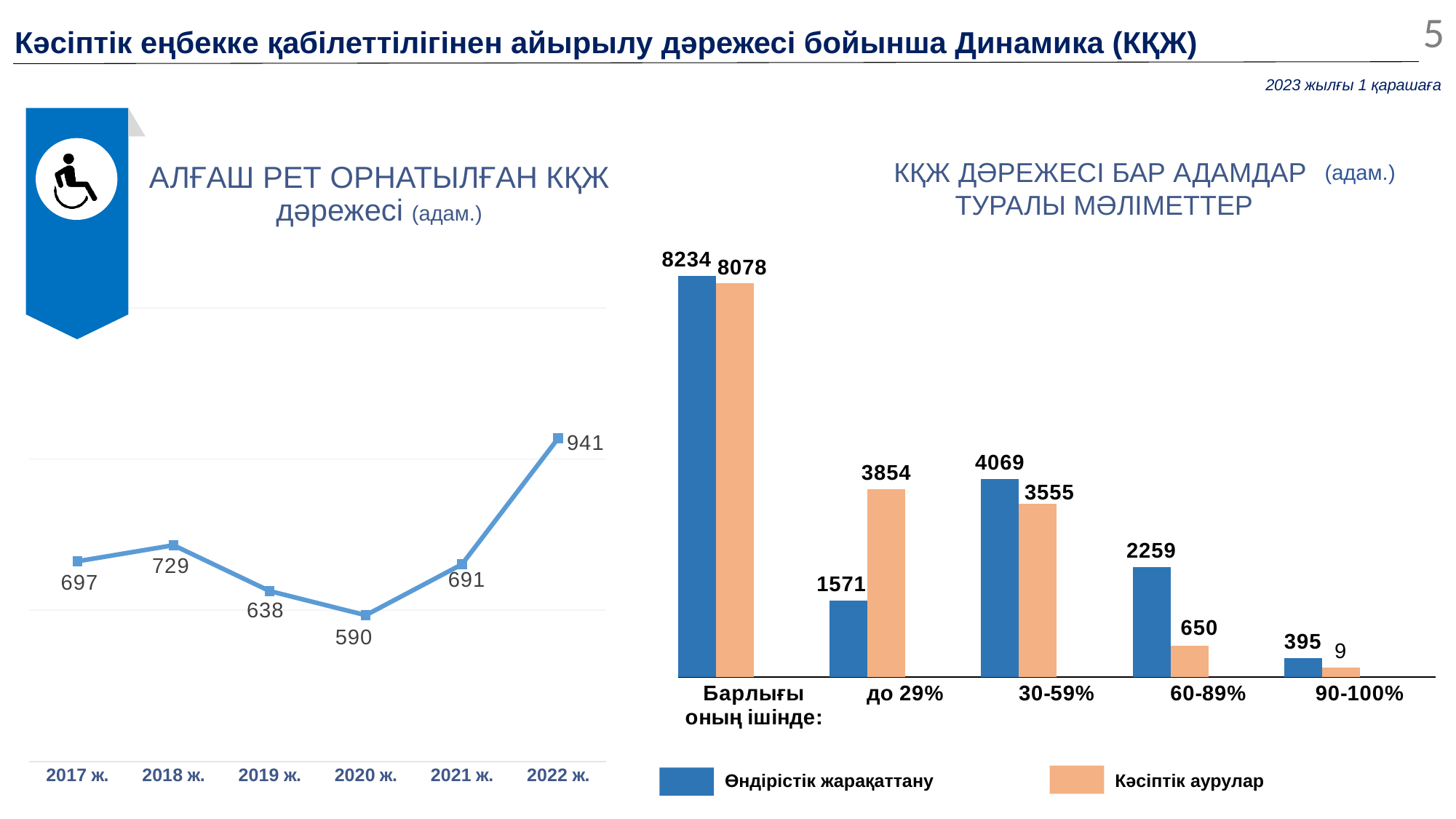
In the left chart (АЛҒАШ РЕТ ОРНАТЫЛҒАН КҚЖ дәрежесі), which year has the lowest value? 2020 ж. In the left chart (АЛҒАШ РЕТ ОРНАТЫЛҒАН КҚЖ дәрежесі), what is the difference between the values for 2022 ж. and 2021 ж.? 250 In the left chart (АЛҒАШ РЕТ ОРНАТЫЛҒАН КҚЖ дәрежесі), what is the value for 2020 ж.? 590 How many series does the legend of the right chart (КҚЖ ДӘРЕЖЕСІ БАР АДАМДАР ТУРАЛЫ МӘЛІМЕТТЕР) list? 2 In the right chart (КҚЖ ДӘРЕЖЕСІ БАР АДАМДАР ТУРАЛЫ МӘЛІМЕТТЕР), what is the value of Өндірістік жарақаттану for 60-89%? 2259 In the right chart (КҚЖ ДӘРЕЖЕСІ БАР АДАМДАР ТУРАЛЫ МӘЛІМЕТТЕР), what is the value of Кәсіптік аурулар for до 29%? 3854 In the left chart (АЛҒАШ РЕТ ОРНАТЫЛҒАН КҚЖ дәрежесі), which year has the highest value? 2022 ж. In the right chart (КҚЖ ДӘРЕЖЕСІ БАР АДАМДАР ТУРАЛЫ МӘЛІМЕТТЕР), which is larger for 30-59%: Өндірістік жарақаттану or Кәсіптік аурулар? Өндірістік жарақаттану What kind of chart is the left chart (АЛҒАШ РЕТ ОРНАТЫЛҒАН КҚЖ дәрежесі)? line chart In the left chart (АЛҒАШ РЕТ ОРНАТЫЛҒАН КҚЖ дәрежесі), do the values rise or fall from 2020 ж. to 2022 ж.? rise In the left chart (АЛҒАШ РЕТ ОРНАТЫЛҒАН КҚЖ дәрежесі), how many years are plotted? 6